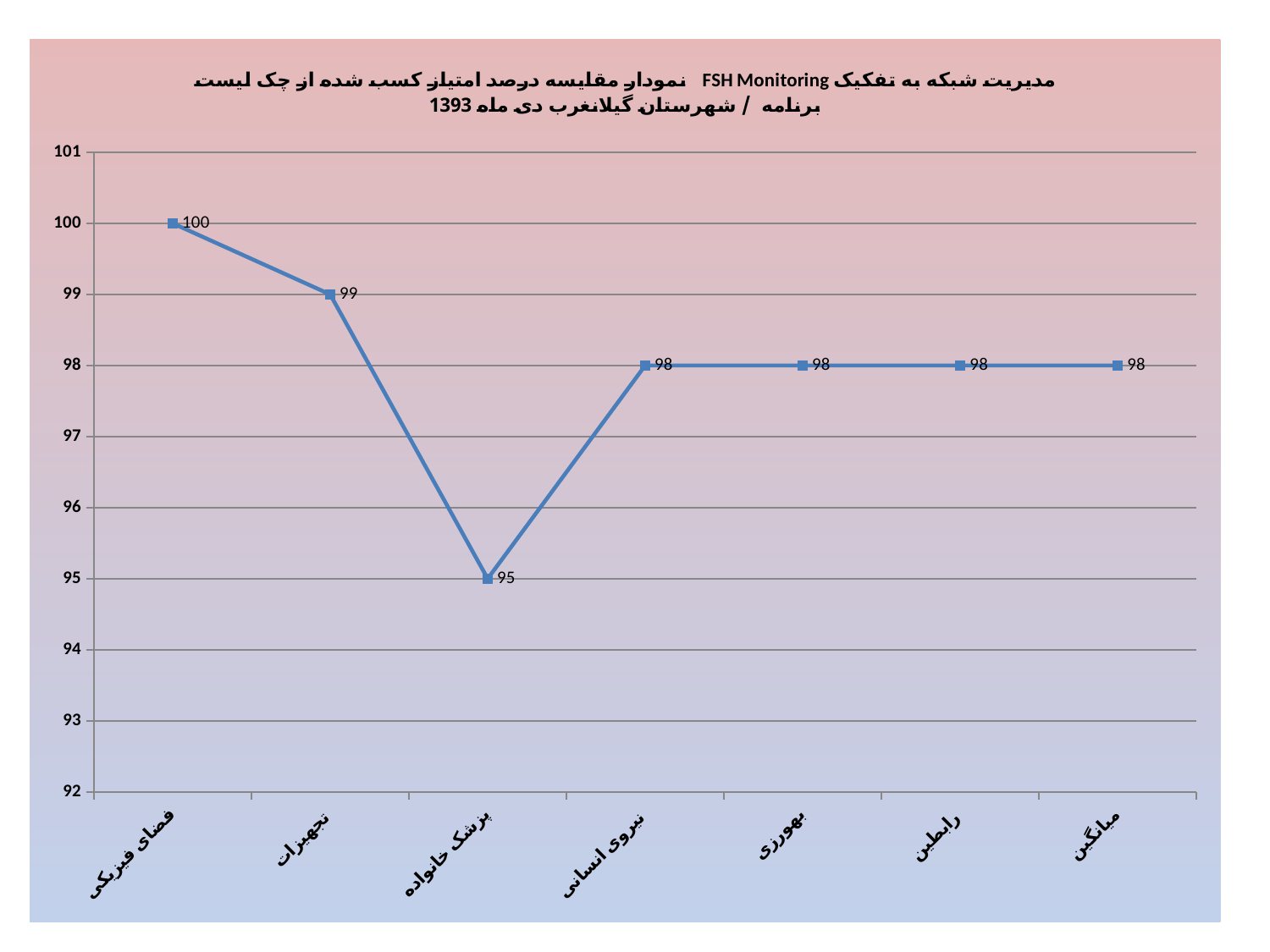
Which is larger, the value for تجهیزات or the value for بهورزی? تجهیزات What is the difference between the values for فضای فیزیکی and پزشک خانواده? 5 What is the difference between the values for تجهیزات and نیروی انسانی? 1 Which category has the lowest value? پزشک خانواده What value is plotted for میانگین? 98 What value is plotted for تجهیزات? 99 Is the value for پزشک خانواده greater or less than 97? less What kind of chart is shown on the slide? line chart What value is plotted for فضای فیزیکی? 100 Which category has the highest value? فضای فیزیکی How many categories are plotted on the x axis? 7 What value is plotted for پزشک خانواده? 95